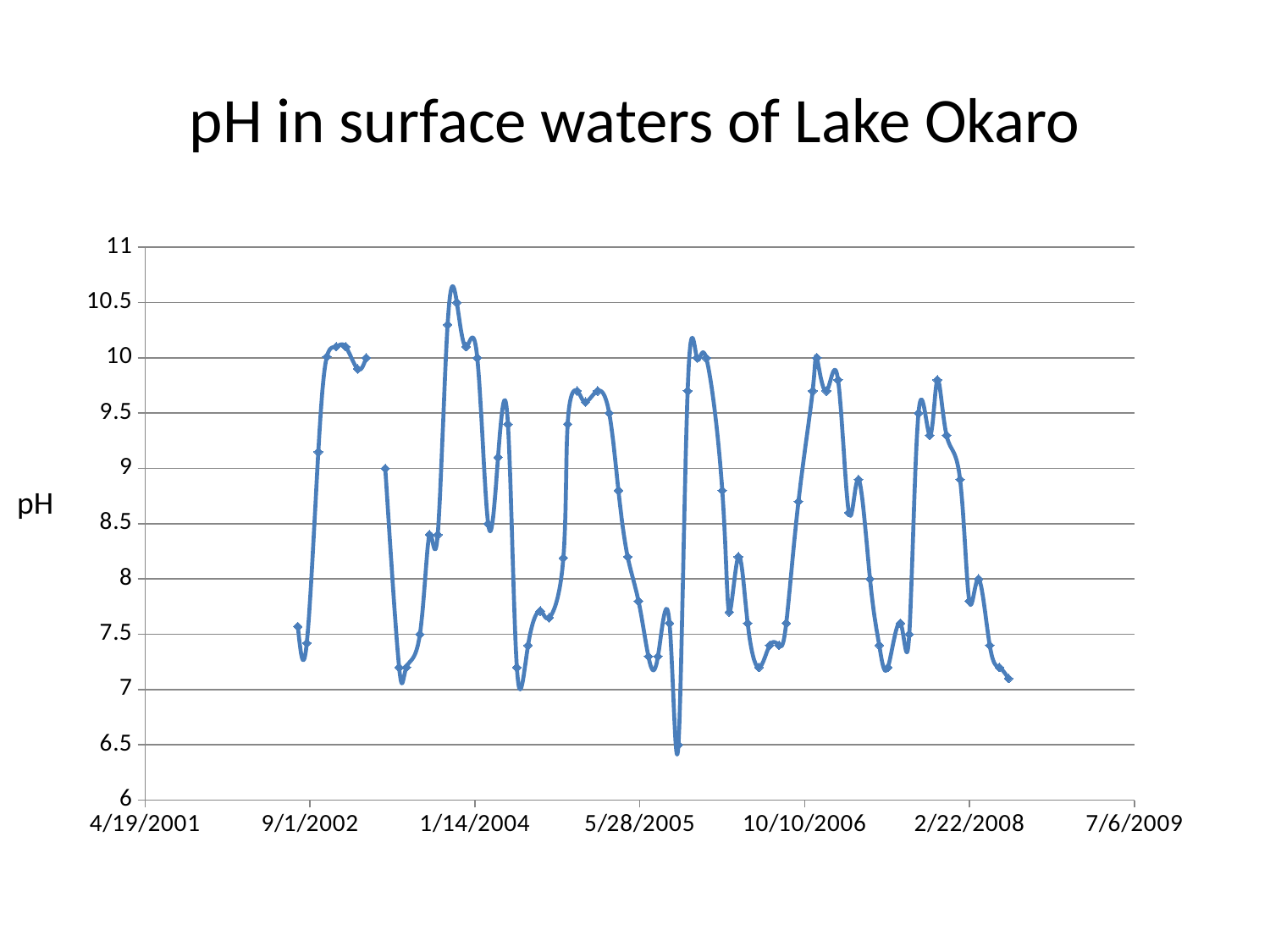
What kind of chart is shown on the slide? line chart Is the peak pH value shortly after 9/1/2002 greater or less than 9.5? greater Which is higher: the peak pH near 1/14/2004 or the peak pH near 2/22/2008? the peak near 1/14/2004 Is the peak pH value near 2/22/2008 greater or less than 9? greater What is the title of the chart? pH in surface waters of Lake Okaro Is the last plotted pH value, after 2/22/2008, greater or less than 7.5? less What label is shown on the vertical axis of the chart? pH Over the whole period, does the pH stay roughly constant or fluctuate repeatedly up and down? fluctuates repeatedly up and down